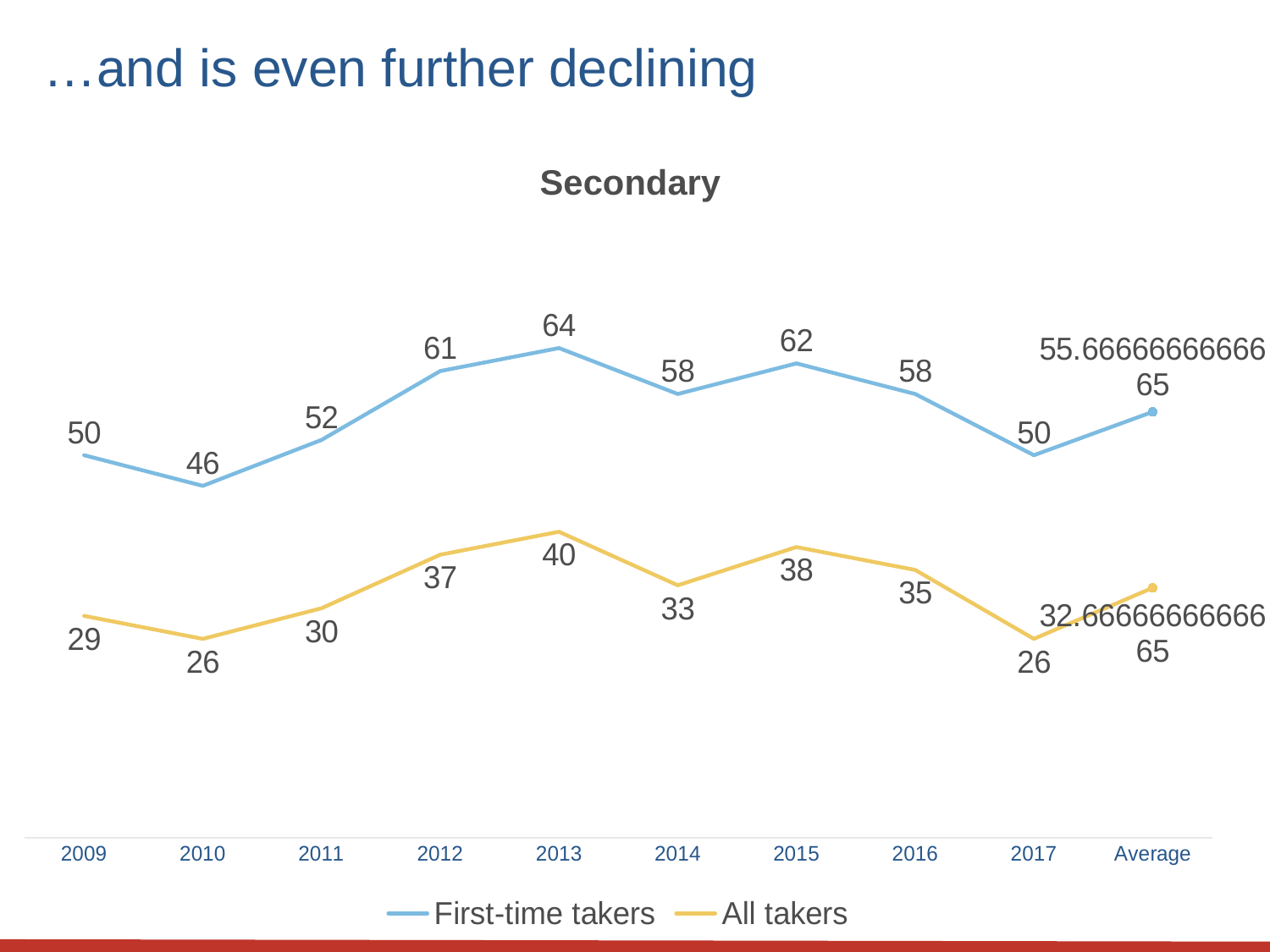
What is the value for All takers in 2017? 26 In which year do First-time takers have their lowest value? 2010 What is the value for First-time takers in 2013? 64 What is the difference between the First-time takers values for 2013 and 2017? 14 Which is larger for All takers: the value in 2015 or the value in 2016? 2015 Do the First-time takers values rise or fall from 2015 to 2017? Fall In which year do All takers reach their highest value? 2013 What is the difference between First-time takers and All takers in 2013? 24 What is the value for First-time takers in 2010? 46 In which year do First-time takers reach their highest value? 2013 What kind of chart is shown on the slide? Line chart How many series does the legend list? 2